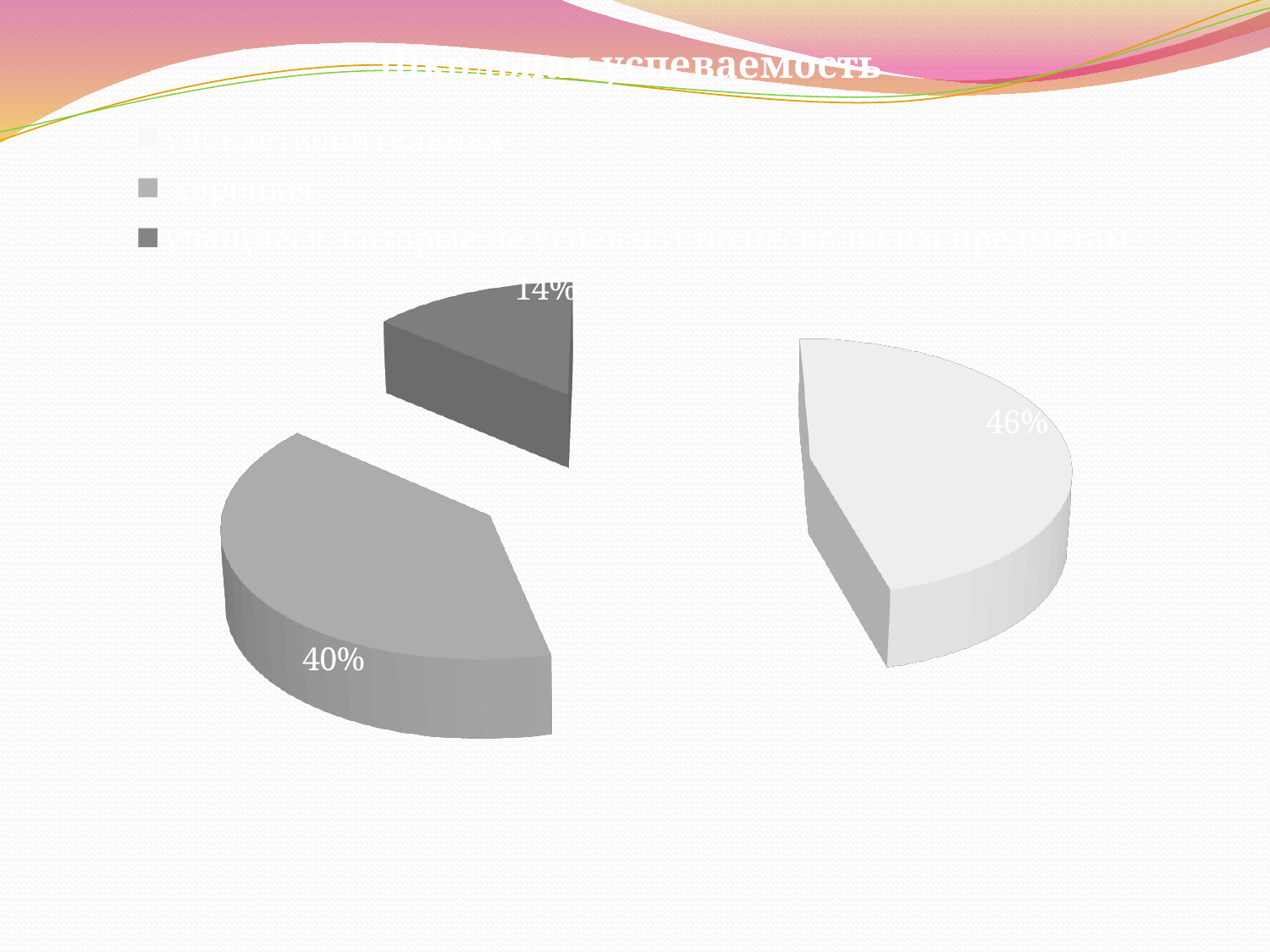
What kind of chart is shown on the slide? pie chart Which is larger, the medium gray slice or the dark gray slice? the medium gray slice (40%) How many entries does the legend of the pie chart list? 3 What is the value of the largest slice of the pie chart? 46% How many slices does the pie chart have? 3 What do the three slice percentages add up to? 100% What is the difference between the largest slice (46%) and the 40% slice? 6 percentage points What is the difference between the 46% slice and the 14% slice? 32 percentage points What percentage is shown on the lightest (white) slice of the pie chart? 46% What is the value of the smallest slice of the pie chart? 14% What percentage is shown on the darkest slice of the pie chart? 14% What share of the pie does the medium gray slice represent? 40%